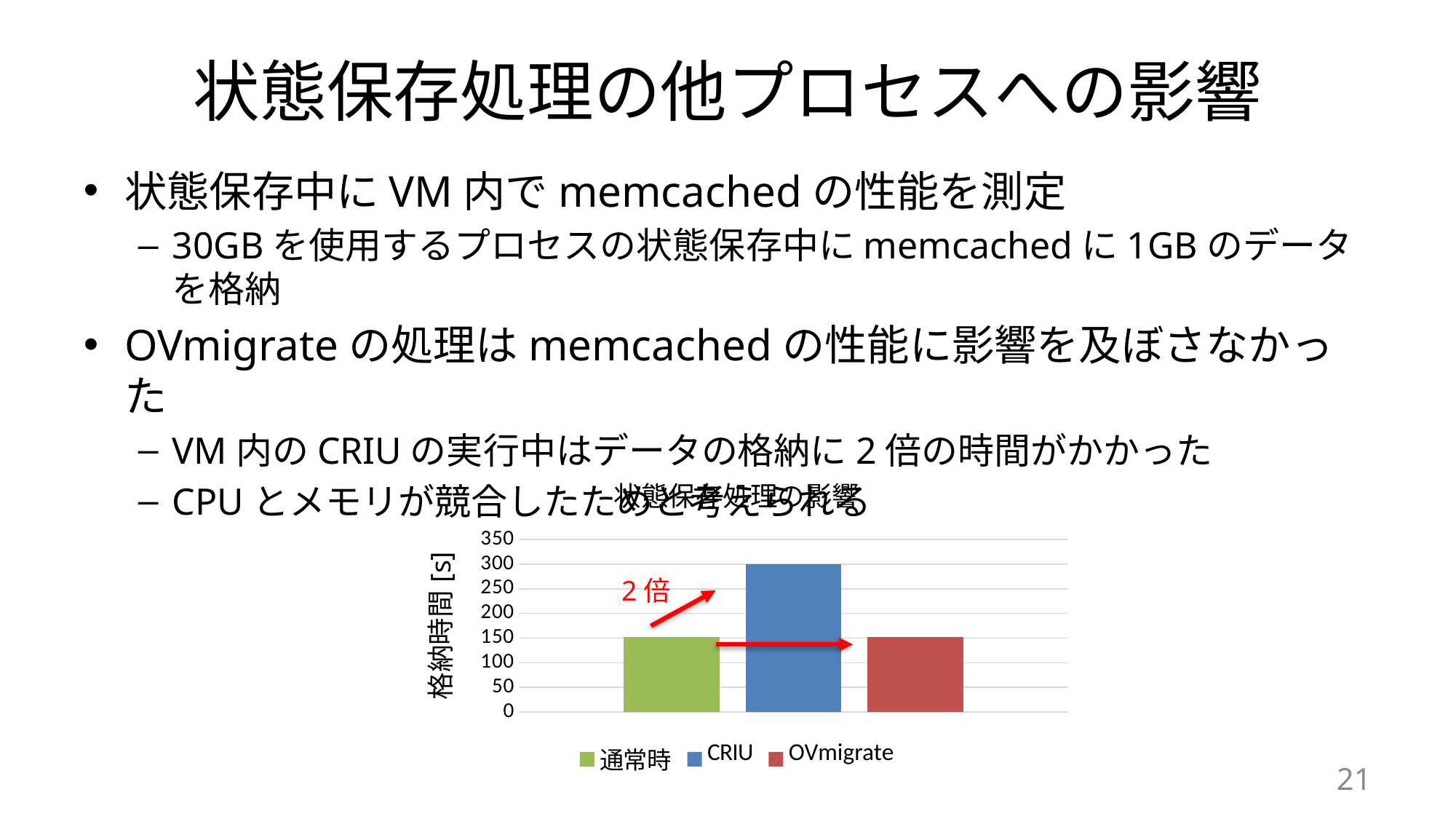
Is the value for CRIU greater or less than 250? greater What colour is the bar for OVmigrate in the chart? red Is the value for OVmigrate greater or less than 200? less What is the highest tick value shown on the vertical axis? 350 Which series has the highest 格納時間 in the chart? CRIU What kind of chart is shown on the slide? bar chart Which is larger, the value for CRIU or the value for OVmigrate? CRIU What is the label of the vertical axis of the chart? 格納時間 [s] How many series does the chart legend list? 3